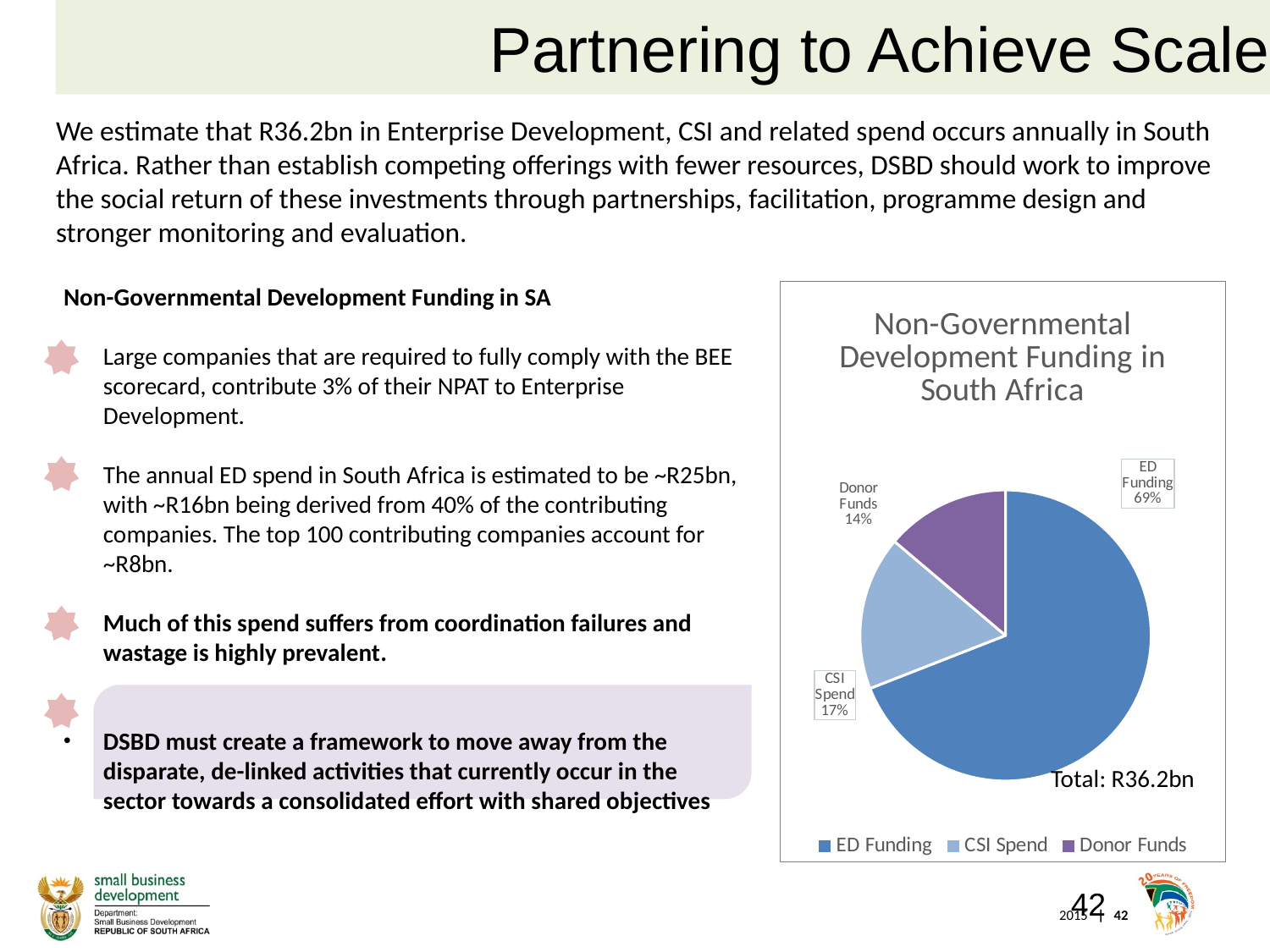
How many entries does the chart legend list? 3 How many slices does the pie chart have? 3 What type of chart is shown on the slide? Pie chart Which category has the smallest slice of the pie? Donor Funds What is the difference in percentage points between the ED Funding and CSI Spend slices? 52 What is the title of the chart? Non-Governmental Development Funding in South Africa Which slice is larger, CSI Spend or Donor Funds? CSI Spend What share of the pie does Donor Funds represent? 14% What share of the pie does ED Funding represent? 69% What is the difference in percentage points between the CSI Spend and Donor Funds slices? 3 What share of the pie does CSI Spend represent? 17% Which category has the largest slice of the pie? ED Funding